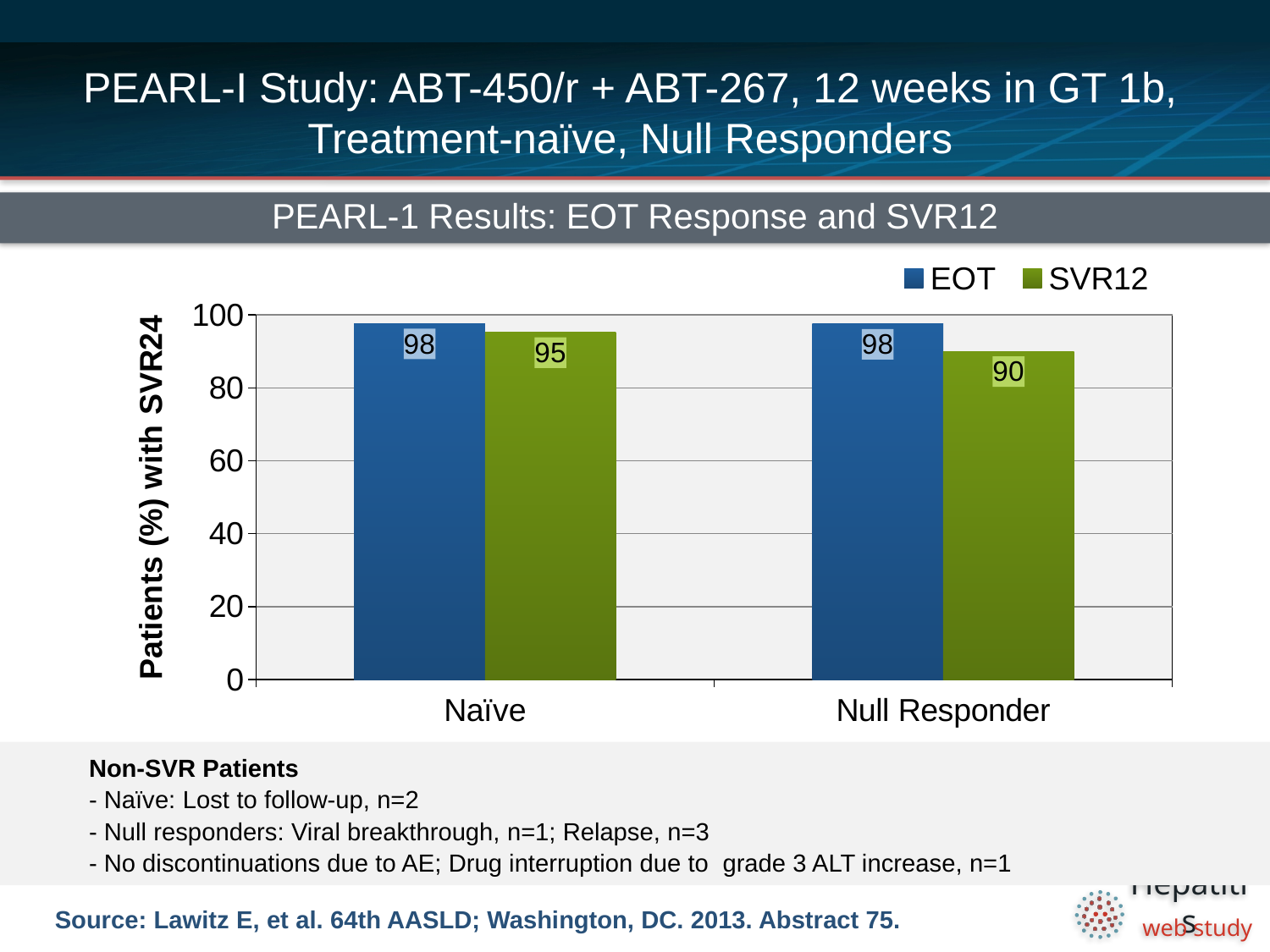
What kind of chart is shown on the slide? Bar chart What is the title of the chart? PEARL-1 Results: EOT Response and SVR12 What is the SVR12 value for the Naïve group? 95 How many patient groups are shown on the x axis? 2 What is the difference between the SVR12 values for the Naïve and Null Responder groups? 5 What is the SVR12 value for the Null Responder group? 90 Which group has the lowest SVR12 value? Null Responder What is the EOT value for the Naïve group? 98 Is the SVR12 value for the Null Responder group greater or less than 80? greater Which is larger, the SVR12 value for Naïve or the SVR12 value for Null Responder? Naïve What is the difference between the EOT and SVR12 values for the Null Responder group? 8 How many series does the legend list? 2